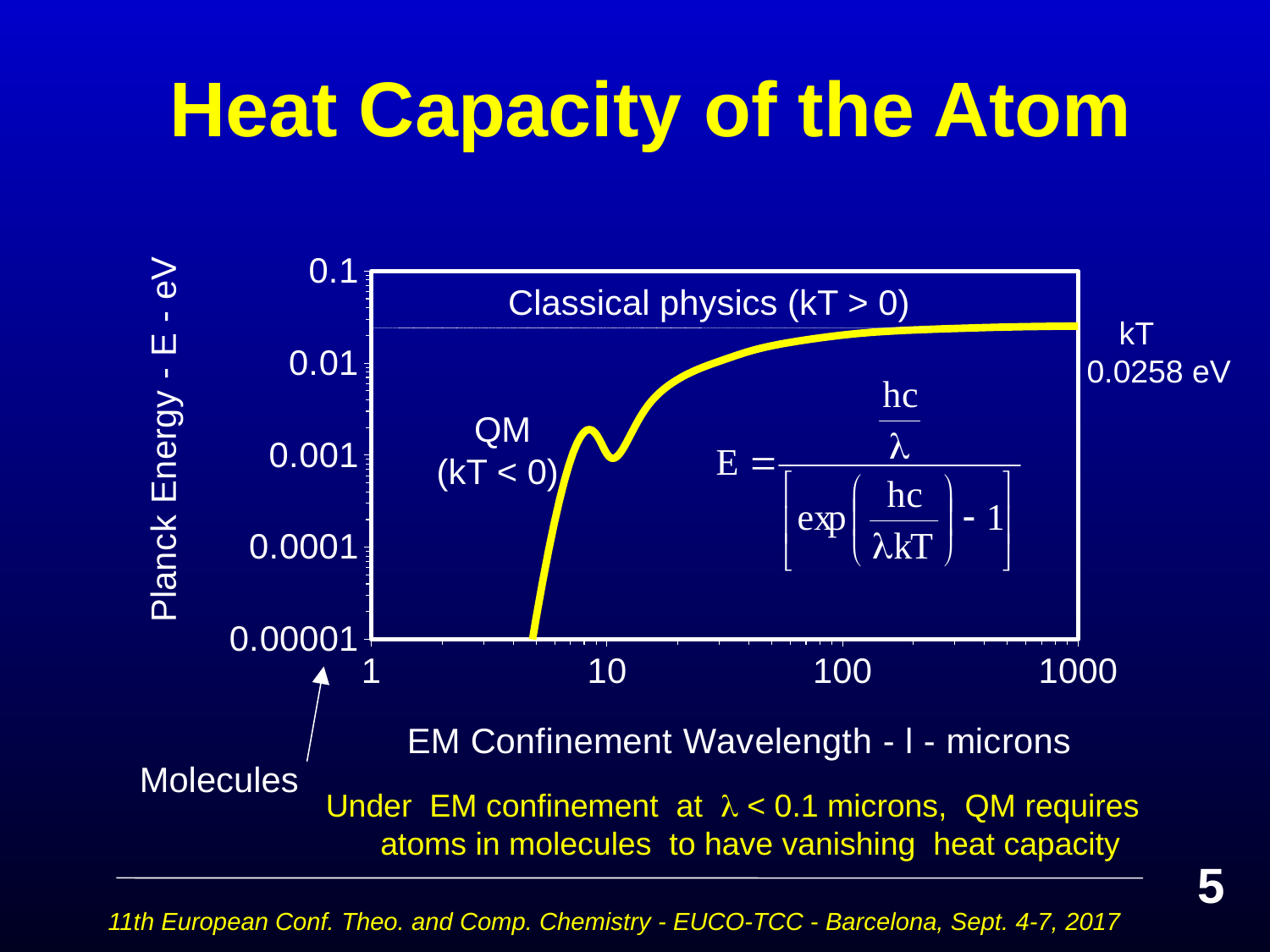
What is the label of the x axis of the chart? EM Confinement Wavelength - l - microns What is the label of the y axis of the chart? Planck Energy - E - eV What is the largest wavelength labelled on the x axis? 1000 What kind of chart is shown on the slide? line chart Is the Planck energy at a wavelength of 1000 microns greater or less than 0.01? greater Is the Planck energy at a wavelength of 1000 microns greater or less than 0.1? less How many tick labels are shown on the y axis of the chart? 5 What is the lowest value labelled on the y axis? 0.00001 Overall, does the Planck energy rise or fall as the wavelength increases from 1 to 1000 microns? rise What value of kT is annotated at the right of the chart? 0.0258 eV What is the highest value labelled on the y axis? 0.1 How many tick labels are shown on the x axis of the chart? 4